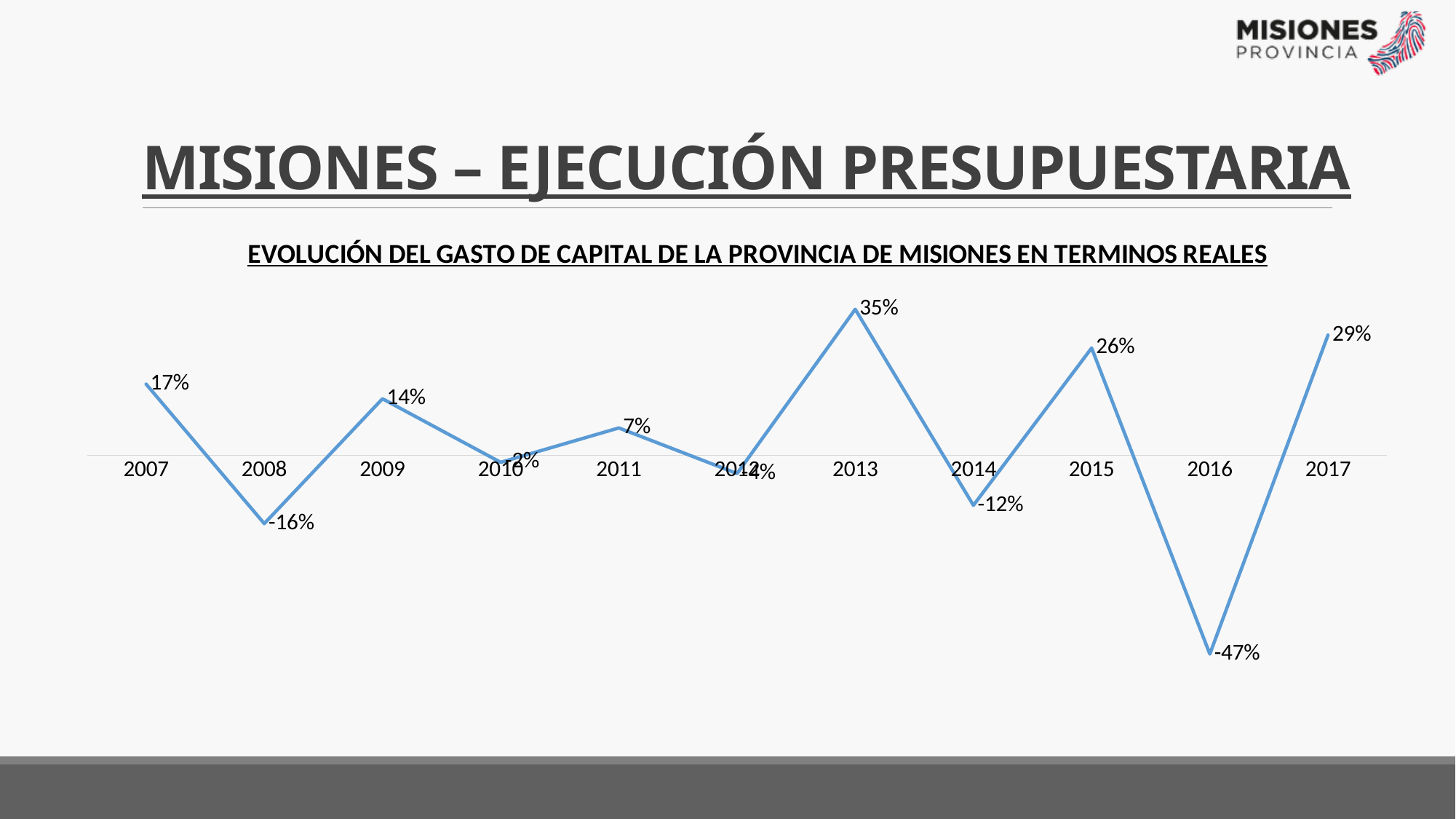
What is the value for 2016? -47% What is the value for 2007? 17% Does the value rise or fall from 2015 to 2016? Fall How many years are plotted on the chart? 11 Which year has the highest value? 2013 What is the value for 2013? 35% What is the value for 2008? -16% Which year has the lowest value? 2016 What is the difference between the values for 2013 and 2015? 9 percentage points What is the value for 2017? 29% What kind of chart is shown on the slide? Line chart Which is larger, the value for 2009 or the value for 2011? 2009